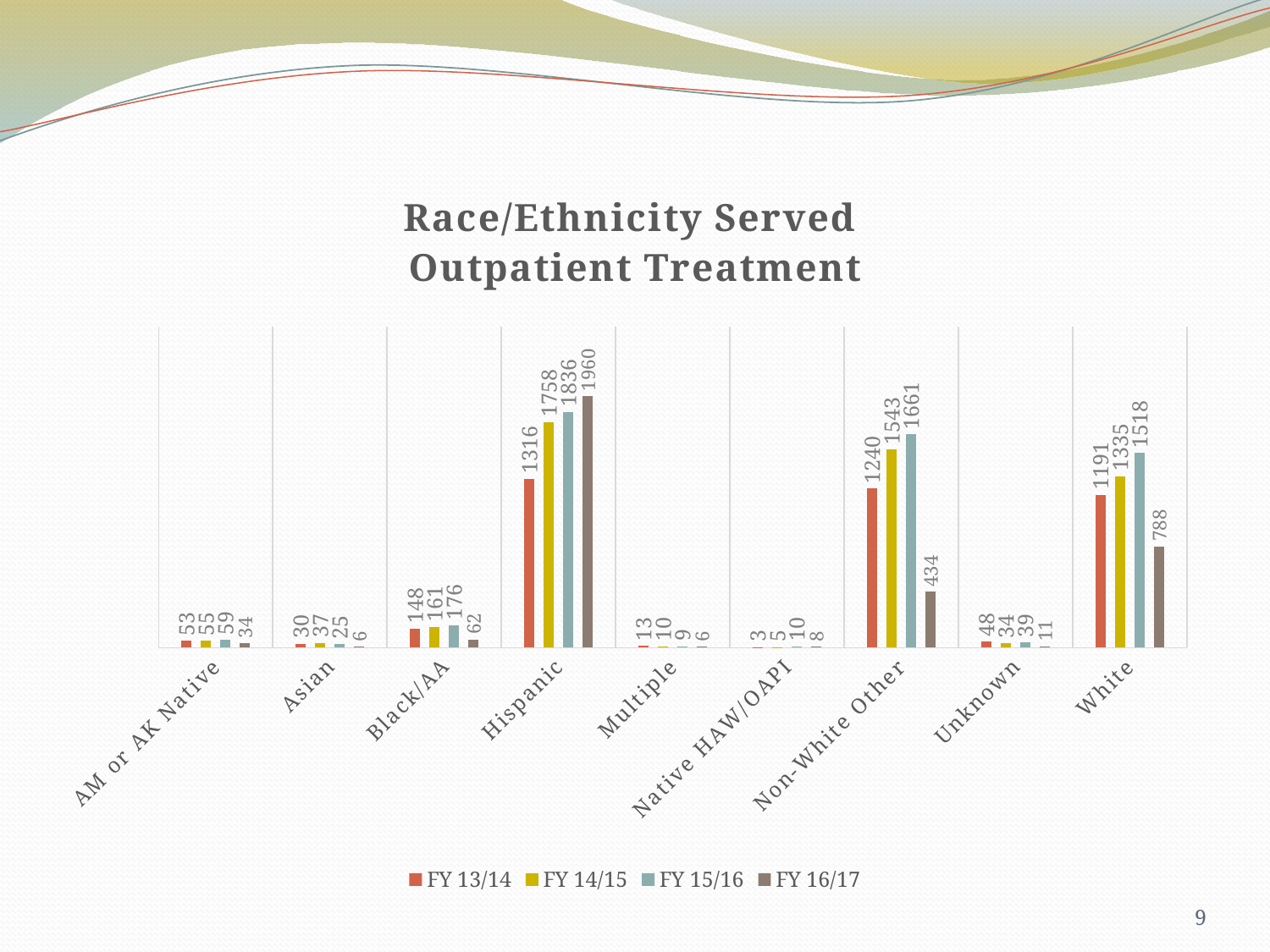
What is the value for White in FY 13/14? 1191 Which is larger: the FY 14/15 value for Hispanic or the FY 14/15 value for Non-White Other? Hispanic Which category has the lowest value in FY 13/14? Native HAW/OAPI What kind of chart is shown? Bar chart How many series does the legend list? 4 What is the value for Non-White Other in FY 16/17? 434 How many race/ethnicity categories are shown on the x axis? 9 Do the values for Hispanic rise or fall from FY 13/14 to FY 16/17? Rise Which category has the highest value in FY 15/16? Hispanic What is the value for Black/AA in FY 15/16? 176 What is the difference between the FY 15/16 and FY 16/17 values for White? 730 What is the value for Hispanic in FY 16/17? 1960